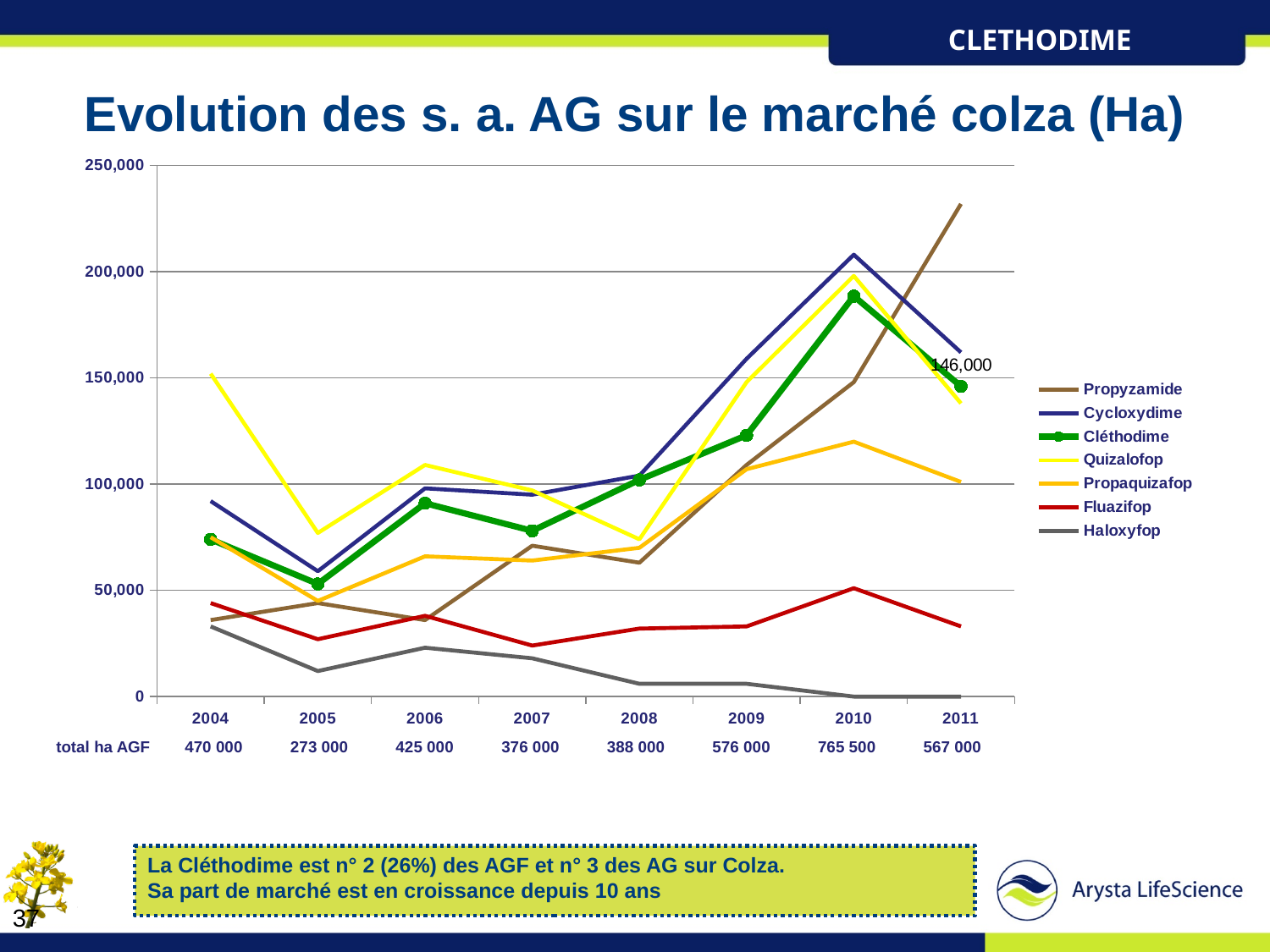
In 2010, which is higher: Cycloxydime or Cléthodime? Cycloxydime Is the value for Quizalofop in 2004 greater or less than 100,000? greater How many years are shown on the x axis? 8 In which year does Cléthodime reach its highest value? 2010 What kind of chart is shown on the slide? line chart What is the title of the chart? Evolution des s. a. AG sur le marché colza (Ha) Does the Haloxyfop line rise or fall from 2004 to 2011? fall Is the value for Propyzamide in 2011 greater or less than 200,000? greater Which series has the lowest value in 2011? Haloxyfop Which series has the highest value in 2011? Propyzamide What is the value for Cléthodime in 2011? 146,000 How many series does the legend list? 7